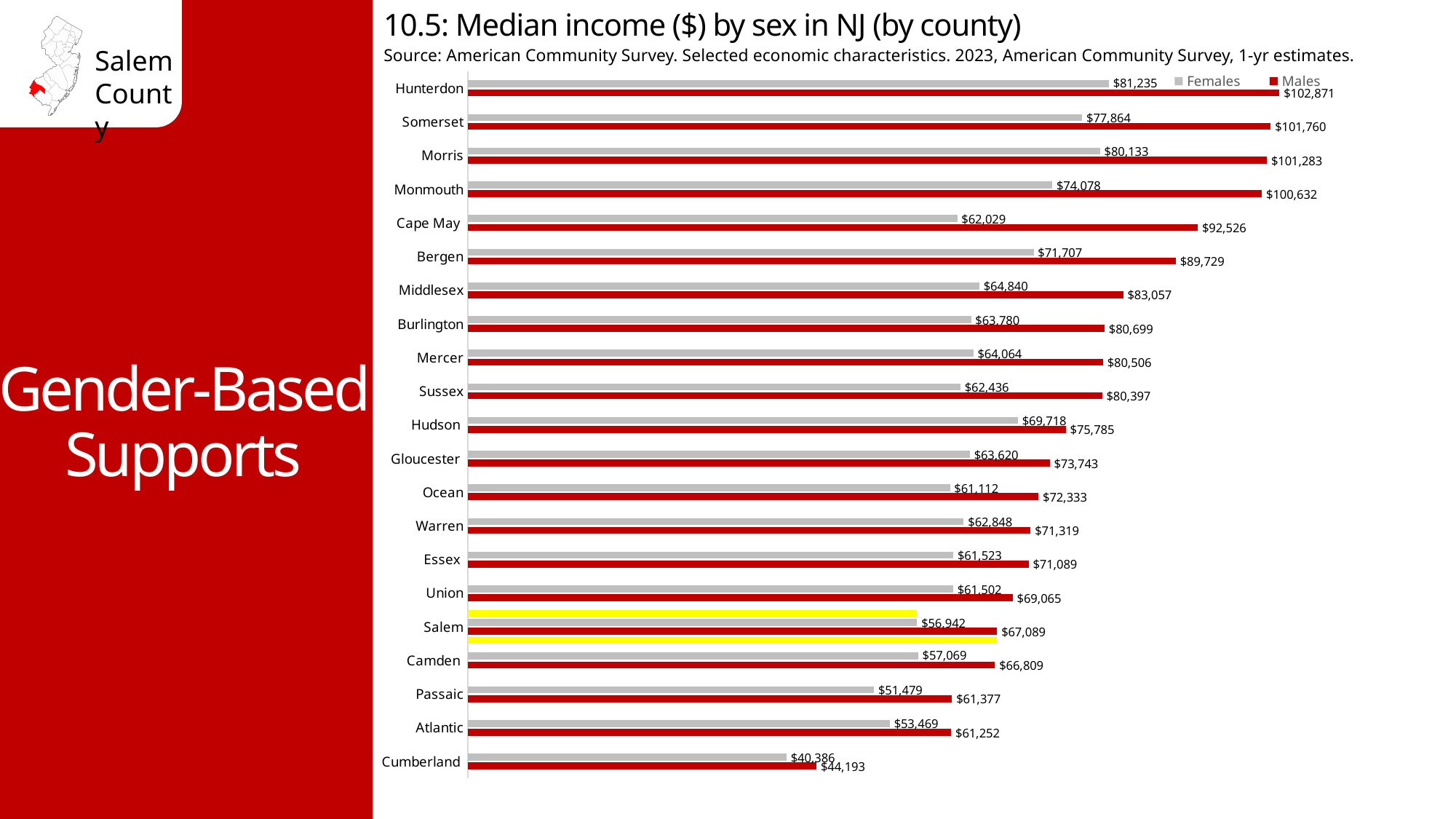
What is the difference between male and female median income in Salem County? $10,147 Which county has the lowest median income for females? Cumberland What type of chart is shown on the slide? Bar chart What is the median income for males in Cape May? $92,526 Which county has the highest median income for males? Hunterdon What is the median income for females in Hudson? $69,718 How many series does the legend list? 2 What is the median income for females in Salem County? $56,942 What is the difference between male and female median income in Hunterdon? $21,636 What is the median income for males in Salem County? $67,089 Which is larger, the female median income in Bergen or in Monmouth? Monmouth How many counties are shown in the chart? 21